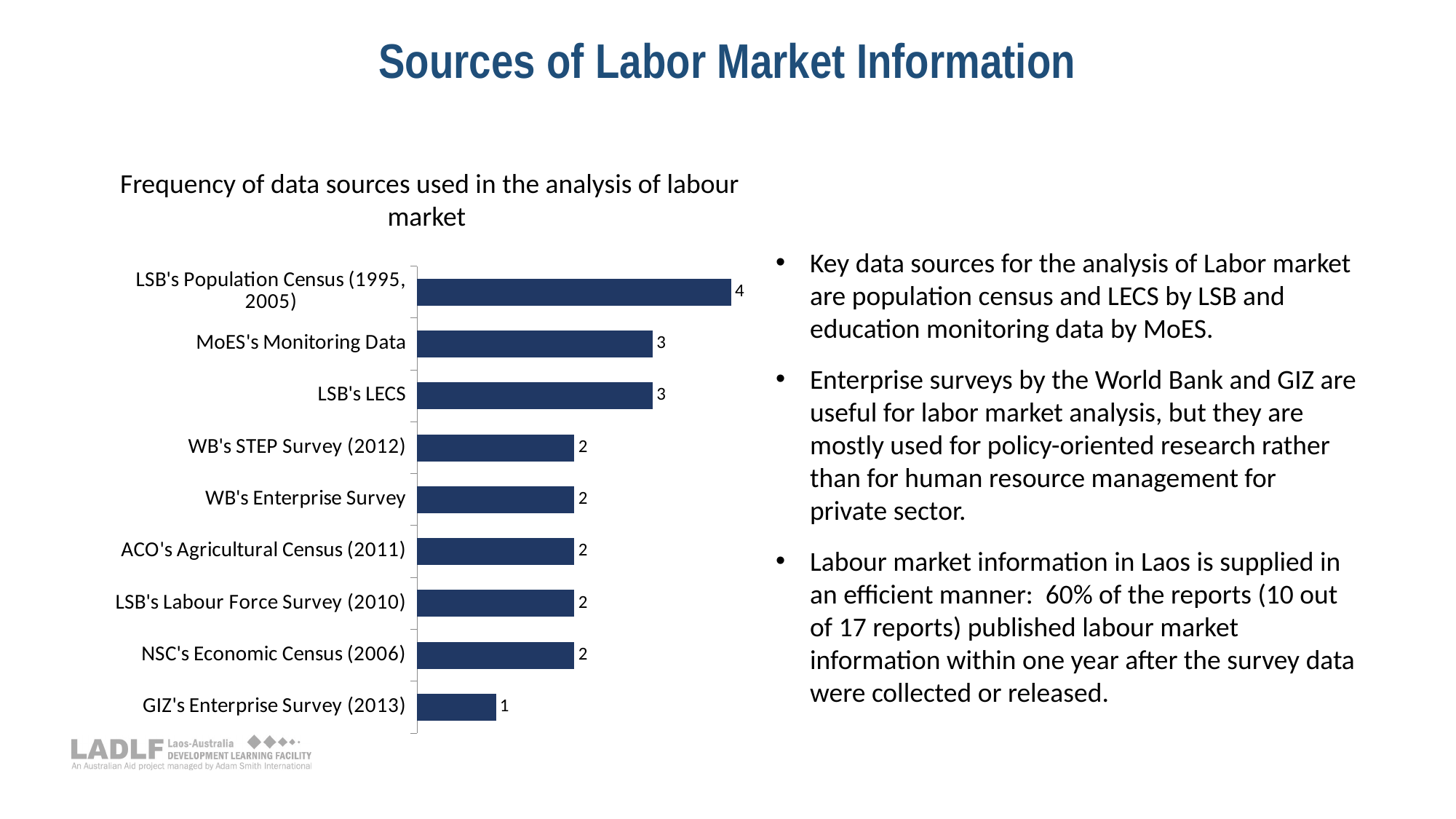
Which is larger, the value for LSB's LECS or the value for NSC's Economic Census (2006)? LSB's LECS What is the value for MoES's Monitoring Data? 3 What is the difference between the values for MoES's Monitoring Data and GIZ's Enterprise Survey (2013)? 2 What is the value for WB's STEP Survey (2012)? 2 What is the value for GIZ's Enterprise Survey (2013)? 1 How many data sources are shown in the chart? 9 What is the title of the chart? Frequency of data sources used in the analysis of labour market What type of chart is shown on the slide? Bar chart Which data source has the highest frequency? LSB's Population Census (1995, 2005) Which data source has the lowest frequency? GIZ's Enterprise Survey (2013) What is the value for LSB's Population Census (1995, 2005)? 4 What is the difference between the values for LSB's Population Census (1995, 2005) and LSB's LECS? 1